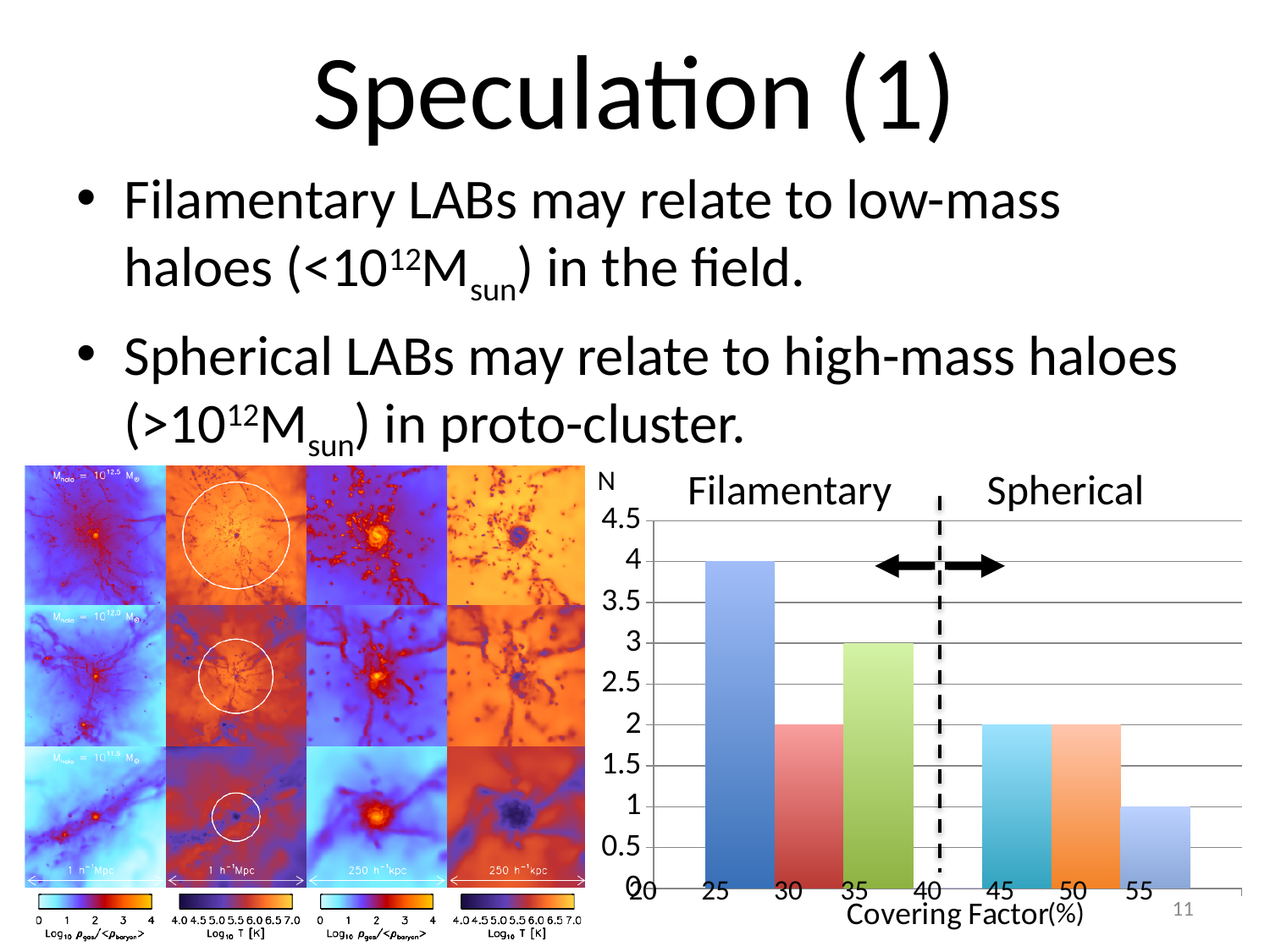
What is the difference between the bar at 25-30 and the bar at 35-40? 1 How many bars are plotted in the bar chart? 6 What kind of chart is shown on the right of the slide? bar chart What is the label of the x axis of the bar chart? Covering Factor(%) What is the value of the bar between 25 and 30 on the Covering Factor axis? 4 What is the label of the y axis of the bar chart? N What is the value of the bar between 35 and 40 on the Covering Factor axis? 3 Which covering factor bin has the tallest bar? 25-30 Is the value of the bar between 45 and 50 greater or less than 3? less Which is taller, the bar at 30-35 or the bar at 35-40? 35-40